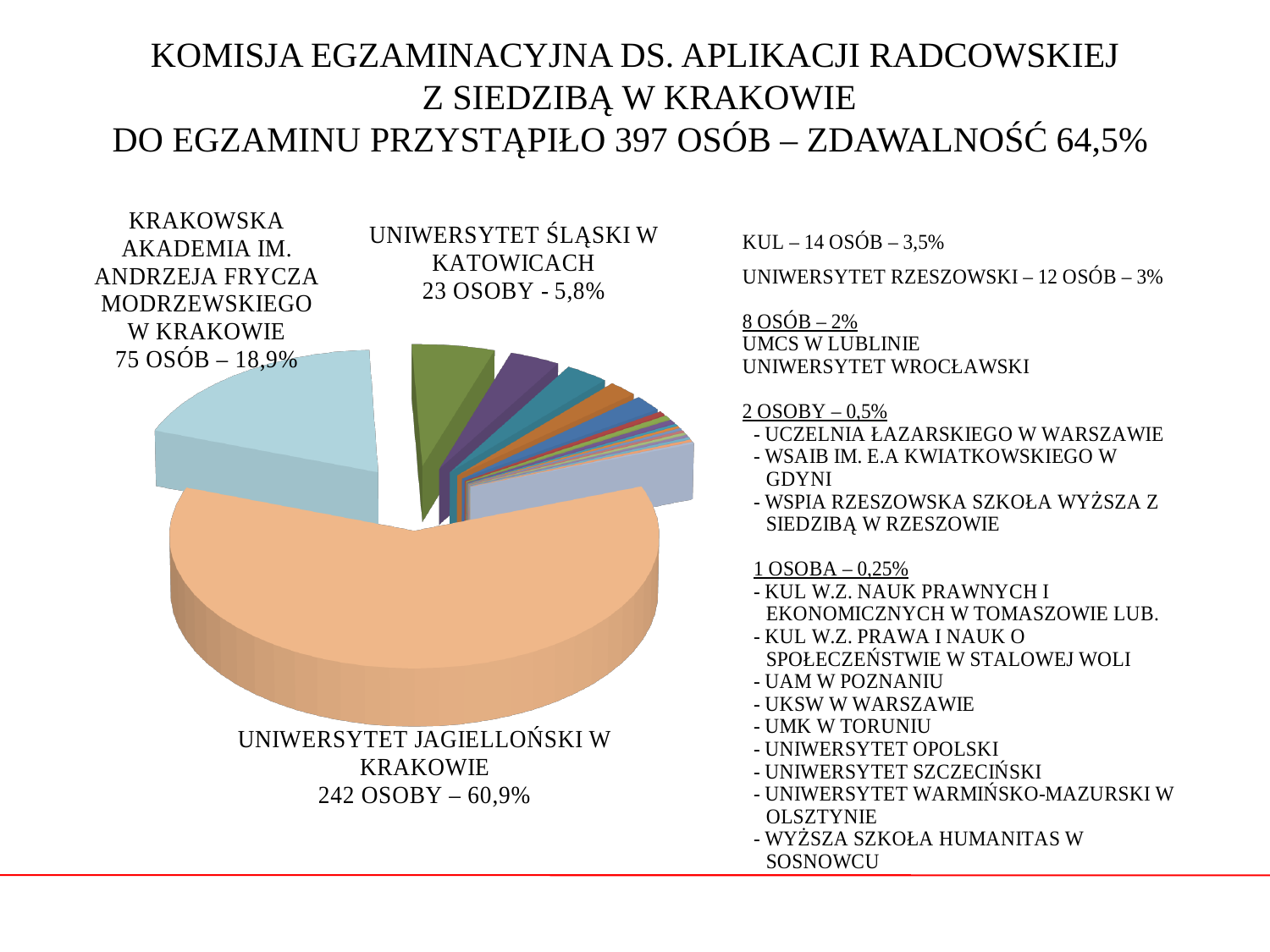
What share of the pie does Uniwersytet Jagielloński w Krakowie represent? 60,9% How many people from Uniwersytet Śląski w Katowicach took the exam? 23 Which university has the largest slice of the pie? Uniwersytet Jagielloński w Krakowie What is the total number of people who took the exam according to the slide title? 397 How many universities are listed with 1 osoba (0,25%)? 9 How many people from Uniwersytet Jagielloński w Krakowie took the exam? 242 What kind of chart is shown on the slide? pie chart What share of the pie does Krakowska Akademia im. Andrzeja Frycza Modrzewskiego w Krakowie represent? 18,9% What is the difference in number of people between Uniwersytet Jagielloński w Krakowie and Krakowska Akademia im. Andrzeja Frycza Modrzewskiego? 167 What percentage is shown for KUL? 3,5% How many people are listed for Uniwersytet Rzeszowski? 12 Which has more people: Uniwersytet Śląski w Katowicach or KUL? Uniwersytet Śląski w Katowicach